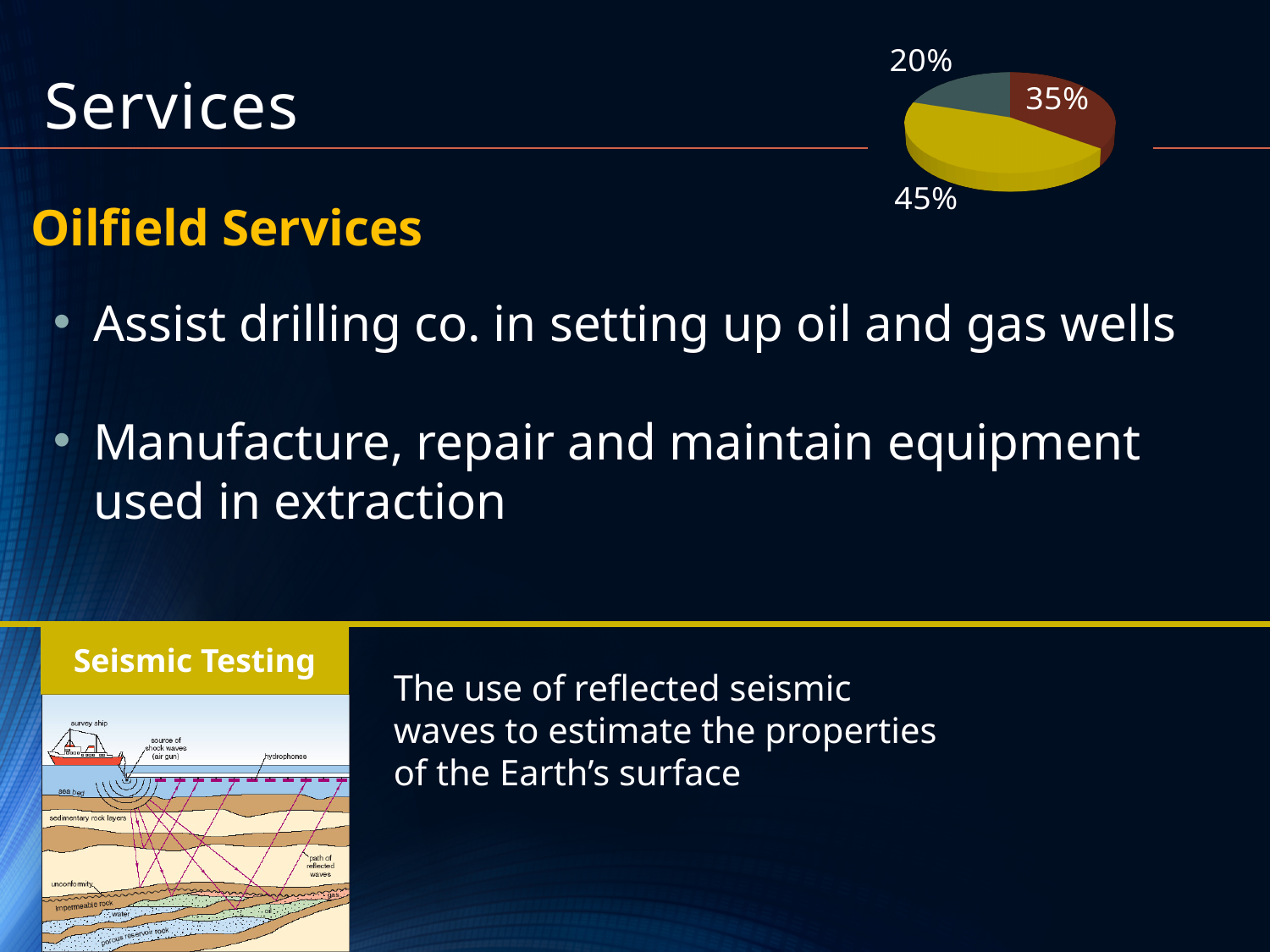
Which is larger in the pie chart, the brown slice or the dark grey slice? brown What is the difference between the largest and smallest slices of the pie chart? 25% Which colour slice of the pie chart is the largest? yellow What is the largest percentage shown on the pie chart? 45% What do the three percentages on the pie chart add up to? 100% How many slices does the pie chart have? 3 What percentage is shown for the brown slice of the pie chart? 35% Which colour slice of the pie chart is the smallest? dark grey What percentage is shown for the yellow slice of the pie chart? 45% What kind of chart is shown in the top right of the slide? pie chart What percentage is shown for the dark grey slice of the pie chart? 20% What is the smallest percentage shown on the pie chart? 20%